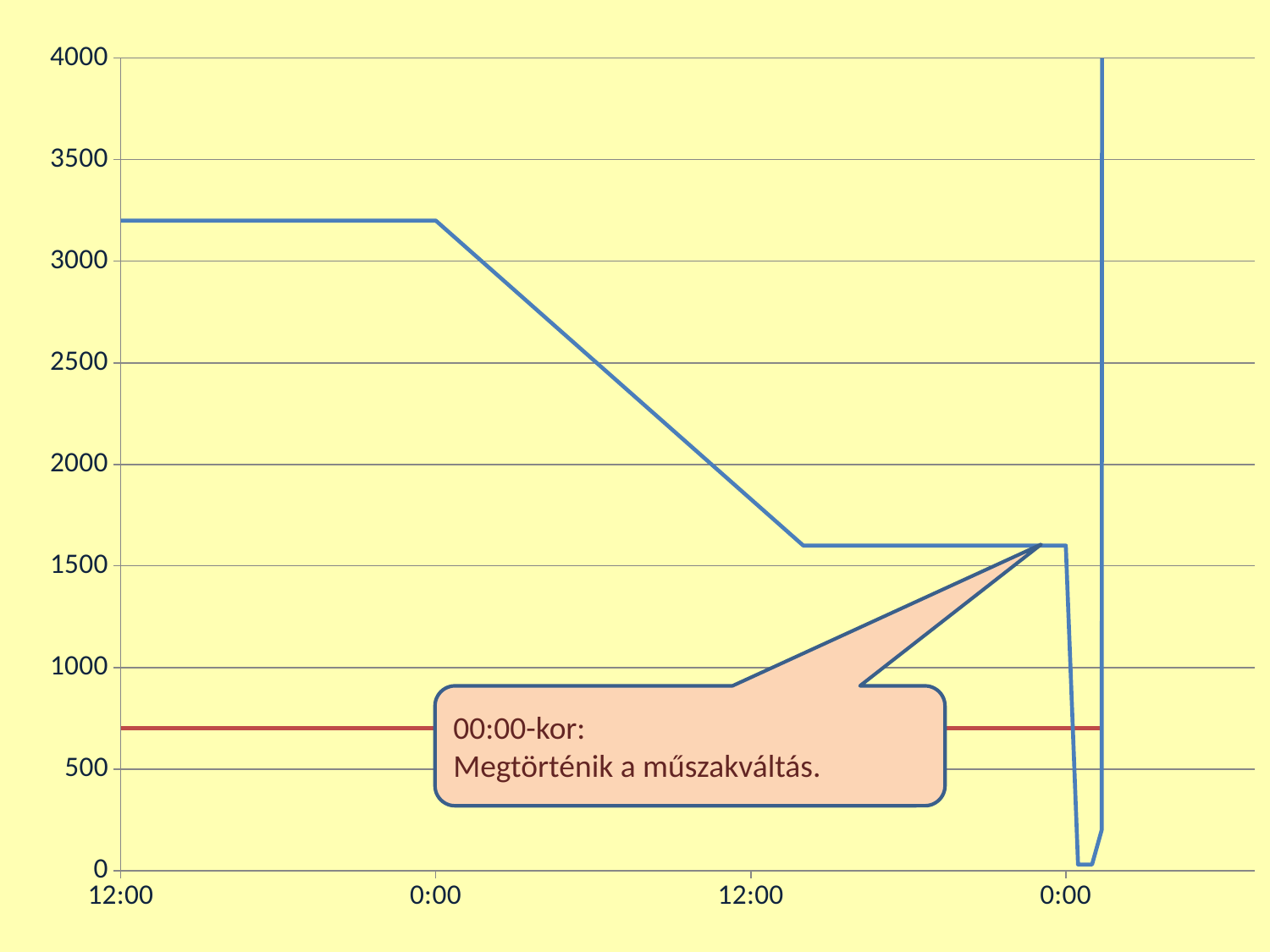
What kind of chart is shown on the slide? line chart Is the value of the red line greater or less than 1000? less Between the first 0:00 tick and the second 12:00 tick, does the blue line rise or fall? fall Is the value of the blue line at the second 12:00 tick greater or less than 2500? less Is the value of the blue line at the first 0:00 tick greater or less than 3000? greater What text is written in the callout box on the chart? 00:00-kor: Megtörténik a műszakváltás. How many tick labels are shown on the x axis? 4 At the first 12:00 tick, which line is higher, the blue line or the red line? the blue line Between the first 12:00 tick and the first 0:00 tick, does the blue line rise, fall or stay flat? stay flat